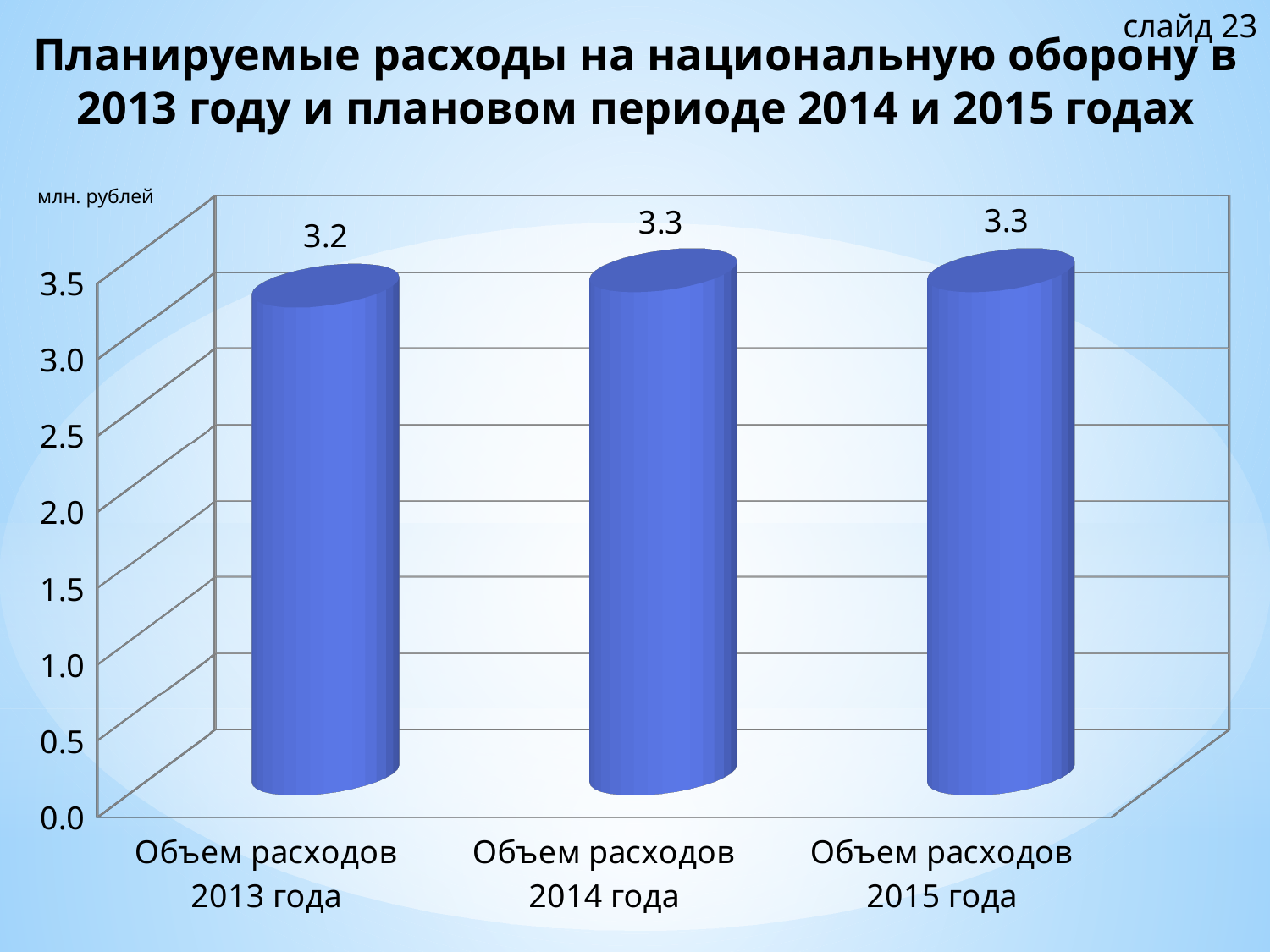
What kind of chart is shown on the slide? bar chart What is the difference between the values for Объем расходов 2014 года and Объем расходов 2013 года? 0.1 Is the value for Объем расходов 2013 года greater or less than 3.0? greater Which category has the lowest value? Объем расходов 2013 года What unit is indicated for the values on the chart? млн. рублей What is the value for Объем расходов 2013 года? 3.2 How many categories are shown on the chart? 3 Is the value for Объем расходов 2015 года greater or less than 3.5? less What is the value for Объем расходов 2014 года? 3.3 Does the value rise or fall from Объем расходов 2013 года to Объем расходов 2014 года? rise Which is larger, the value for Объем расходов 2013 года or Объем расходов 2014 года? Объем расходов 2014 года What is the value for Объем расходов 2015 года? 3.3